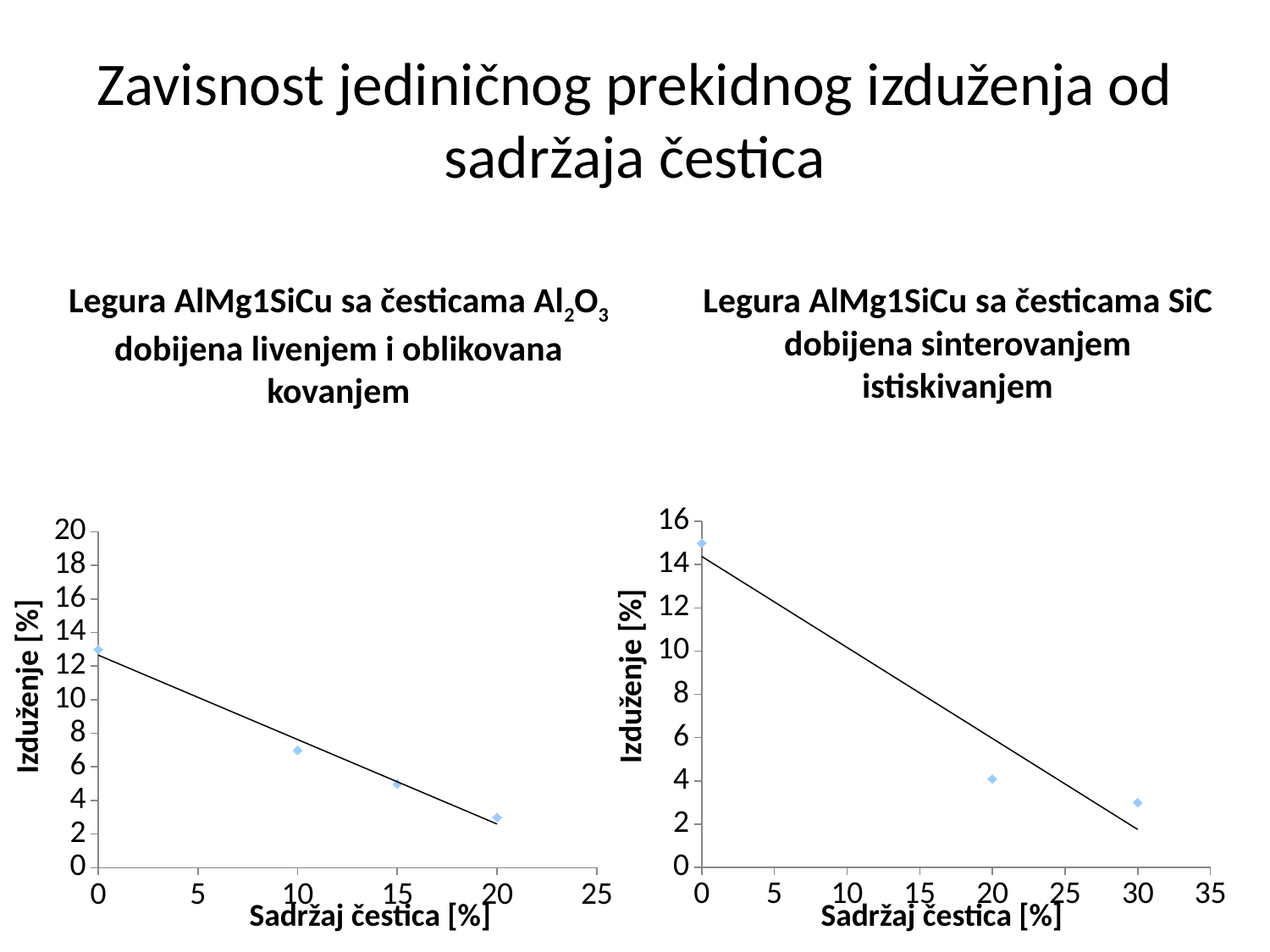
On the right chart (SiC), at which particle content is the elongation lowest? 30 How many data points are plotted on the right chart (Legura AlMg1SiCu sa česticama SiC)? 3 On the left chart (Al2O3), does the elongation rise or fall as the particle content increases? fall On the left chart (Al2O3), is the elongation at 0% particle content greater or less than 10? greater What kind of chart is the left chart (Legura AlMg1SiCu sa česticama Al2O3)? scatter chart On the left chart (Al2O3), is the elongation at 20% particle content greater or less than 4? less On the left chart (Al2O3), at which particle content is the elongation highest? 0 On the right chart (SiC), which has the larger elongation: 20% or 30% particle content? 20% What is the y-axis title of the right chart (SiC)? Izduženje [%] On the right chart (SiC), is the elongation at 0% particle content greater or less than 14? greater How many data points are plotted on the left chart (Legura AlMg1SiCu sa česticama Al2O3)? 4 On the right chart (SiC), does the elongation rise or fall as the particle content increases? fall